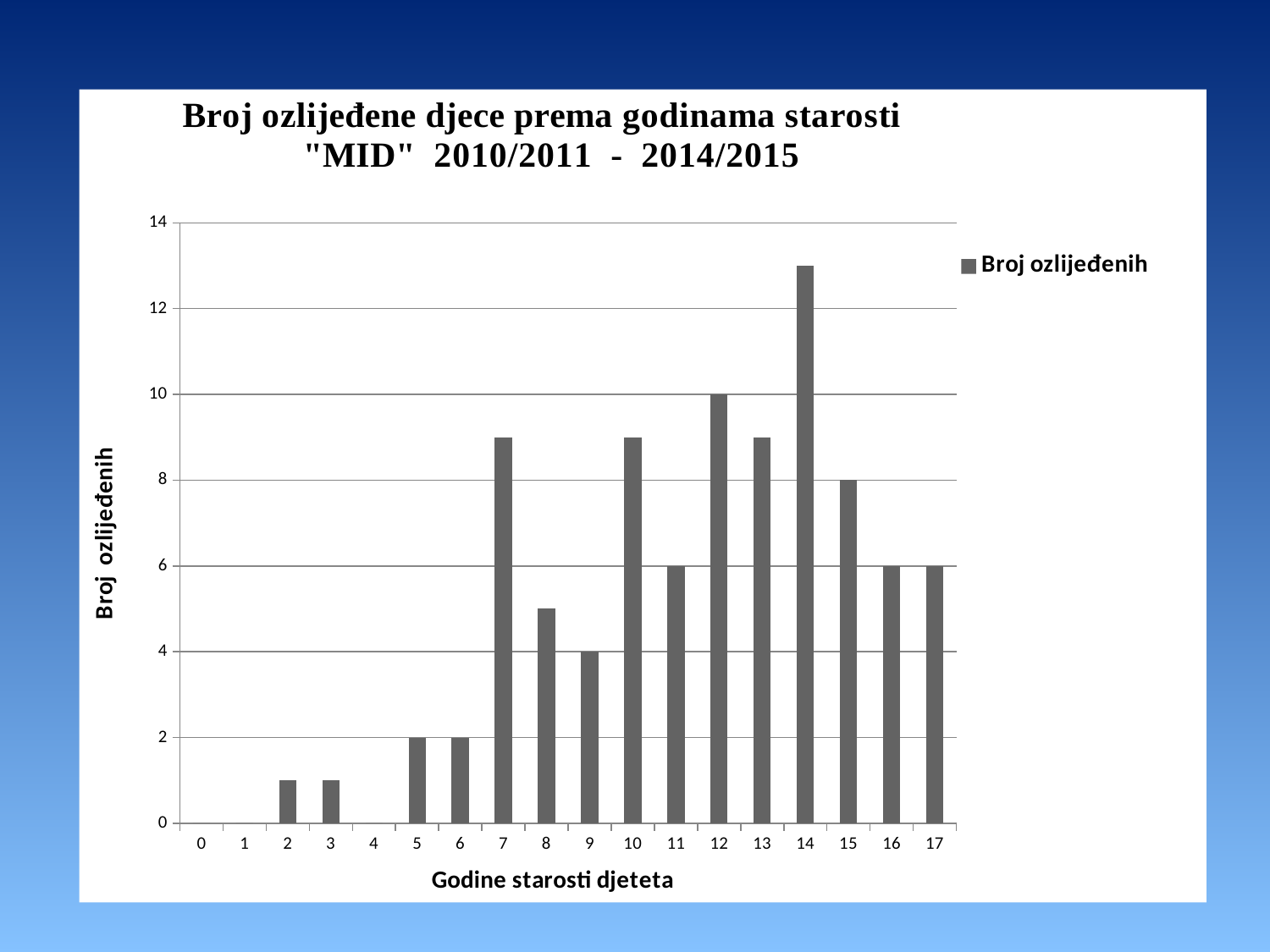
Is the value for age 14 greater or less than 12? greater What is the value of Broj ozlijeđenih for age 12? 10 Which is larger, the value for age 12 or the value for age 15? age 12 Is the value for age 8 greater or less than 6? less What is the value of Broj ozlijeđenih for age 15? 8 What is the value of Broj ozlijeđenih for age 9? 4 What is the title of the chart? Broj ozlijeđene djece prema godinama starosti "MID" 2010/2011 - 2014/2015 What is the difference between the values for age 12 and age 16? 4 How many series does the legend list? 1 What kind of chart is shown on the slide? bar chart How many age categories are shown on the x axis? 18 Which age has the highest number of injured children (Broj ozlijeđenih)? 14